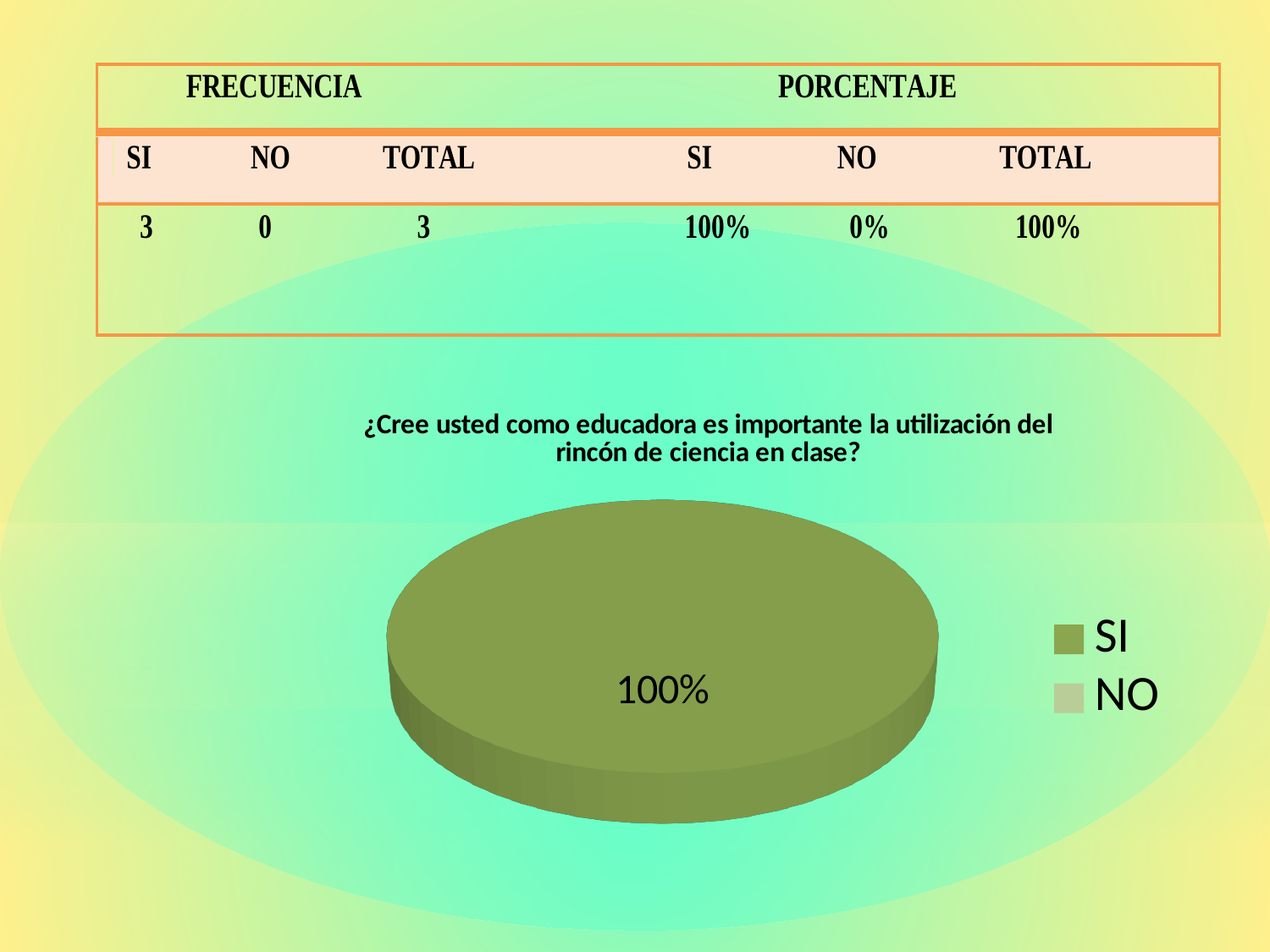
What kind of chart is shown on the slide? pie chart Which is larger in the pie chart, SI or NO? SI Which category has the largest slice in the pie chart? SI What is the title of the pie chart? ¿Cree usted como educadora es importante la utilización del rincón de ciencia en clase? How many entries does the legend of the pie chart list? 2 Which category has the smallest share in the pie chart? NO What is the only percentage label printed on the pie chart? 100% What share of the pie chart does the SI slice represent? 100% What share of the pie chart does the NO category represent? 0% What colour is the SI slice in the pie chart? olive green